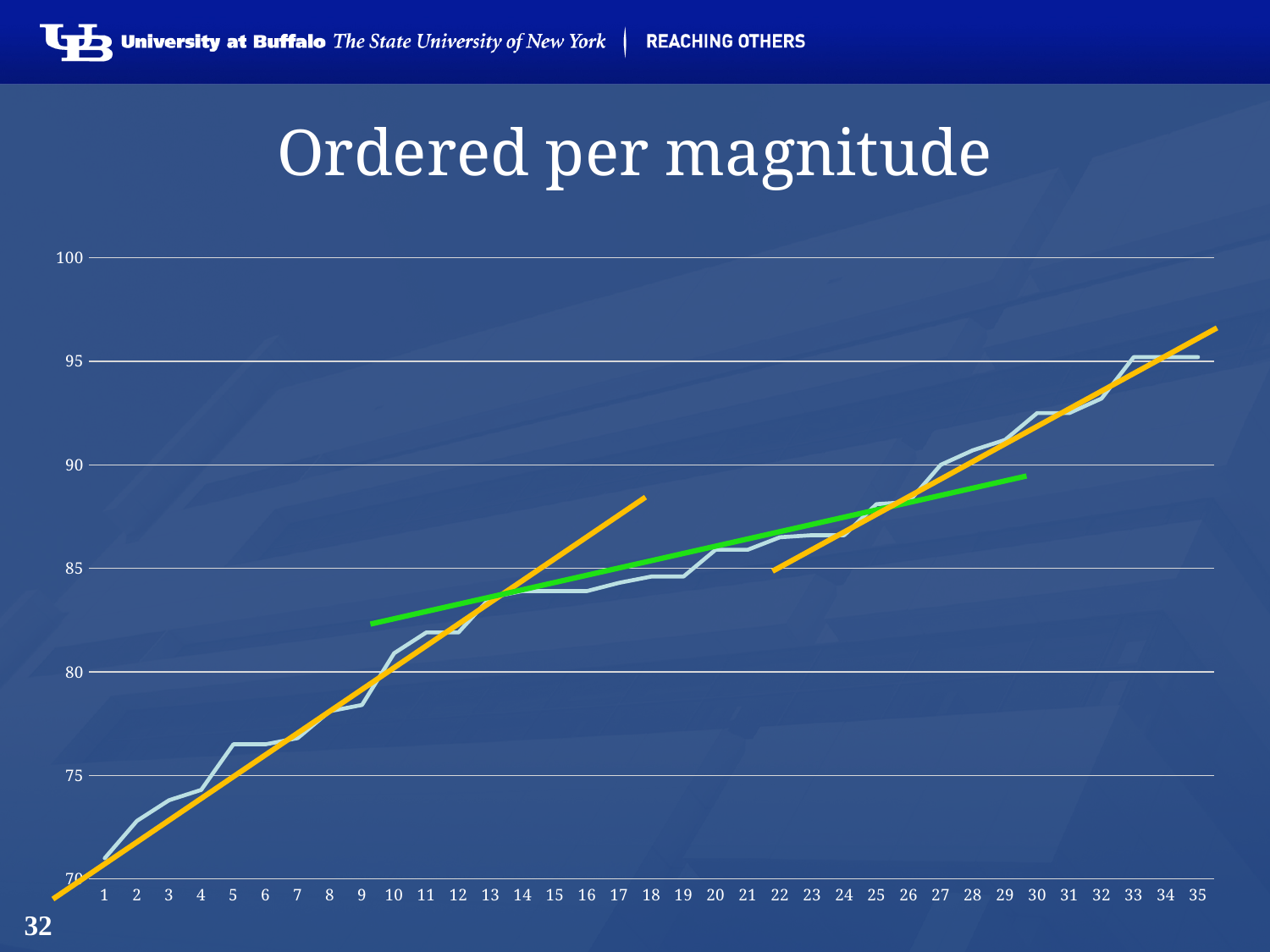
Do the values of the light blue line rise or fall as the x axis goes from 1 to 35? rise Is the value at point 35 greater or less than 90? greater Is the value at point 27 greater or less than 85? greater Is the value at point 10 greater or less than 85? less What is the title of the chart? Ordered per magnitude How many points are plotted along the x axis of the chart? 35 Which x-axis point has the lowest value on the light blue line? 1 What kind of chart is shown on the slide? line chart Which has the larger value on the light blue line, point 1 or point 35? 35 What are the lowest and highest values shown on the y axis? 70 and 100